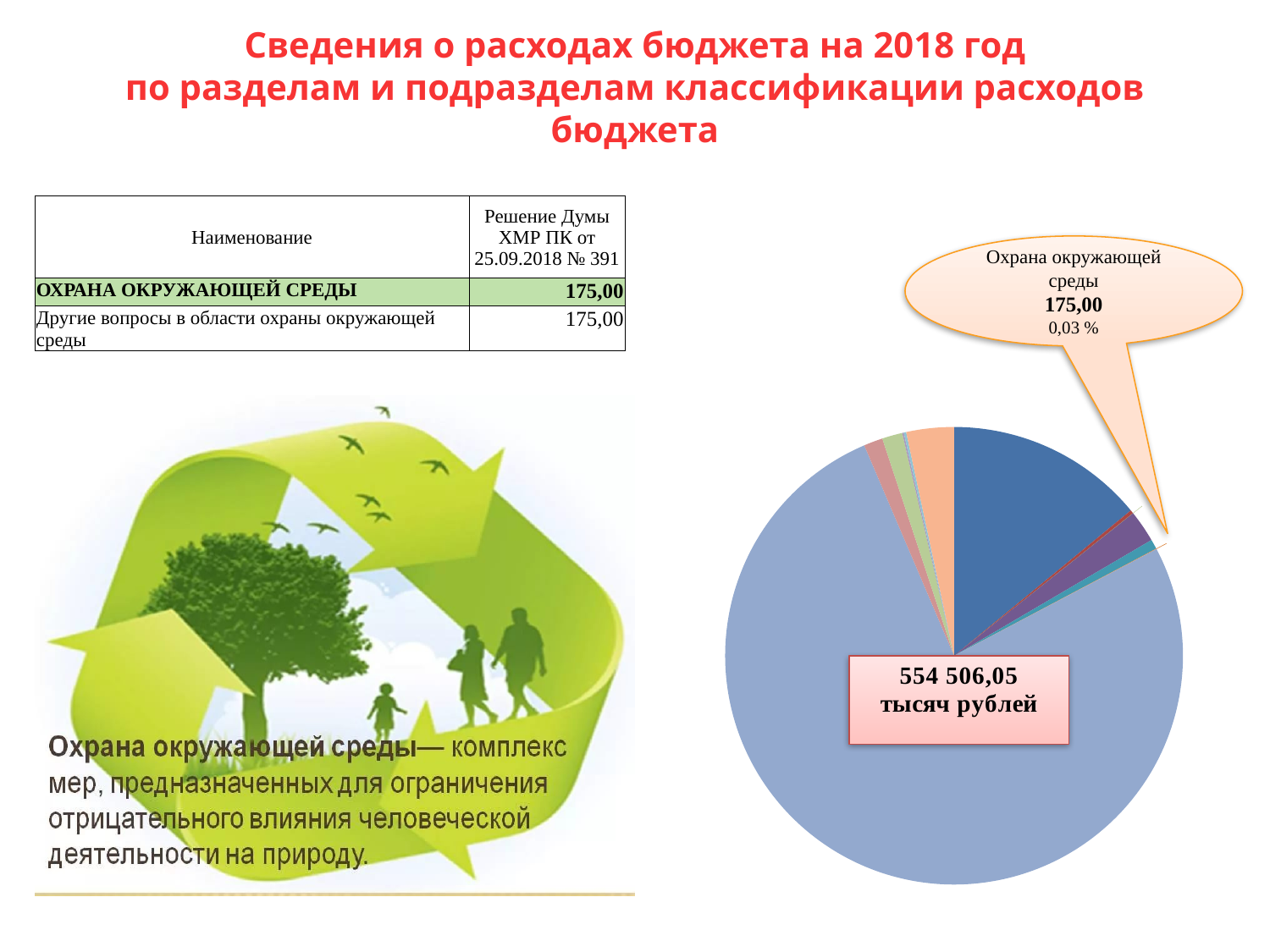
Does the pie chart display a legend listing its categories? No What kind of chart is shown on the right side of the slide? pie chart In the pie chart, what share of the total does Охрана окружающей среды represent according to the callout? 0,03 % Is the share of Охрана окружающей среды in the pie chart greater or less than 1 %? less Which category is highlighted by the callout on the pie chart? Охрана окружающей среды In the pie chart, what value is shown in the callout for Охрана окружающей среды? 175,00 What total amount is printed in the box on the pie chart? 554 506,05 тысяч рублей